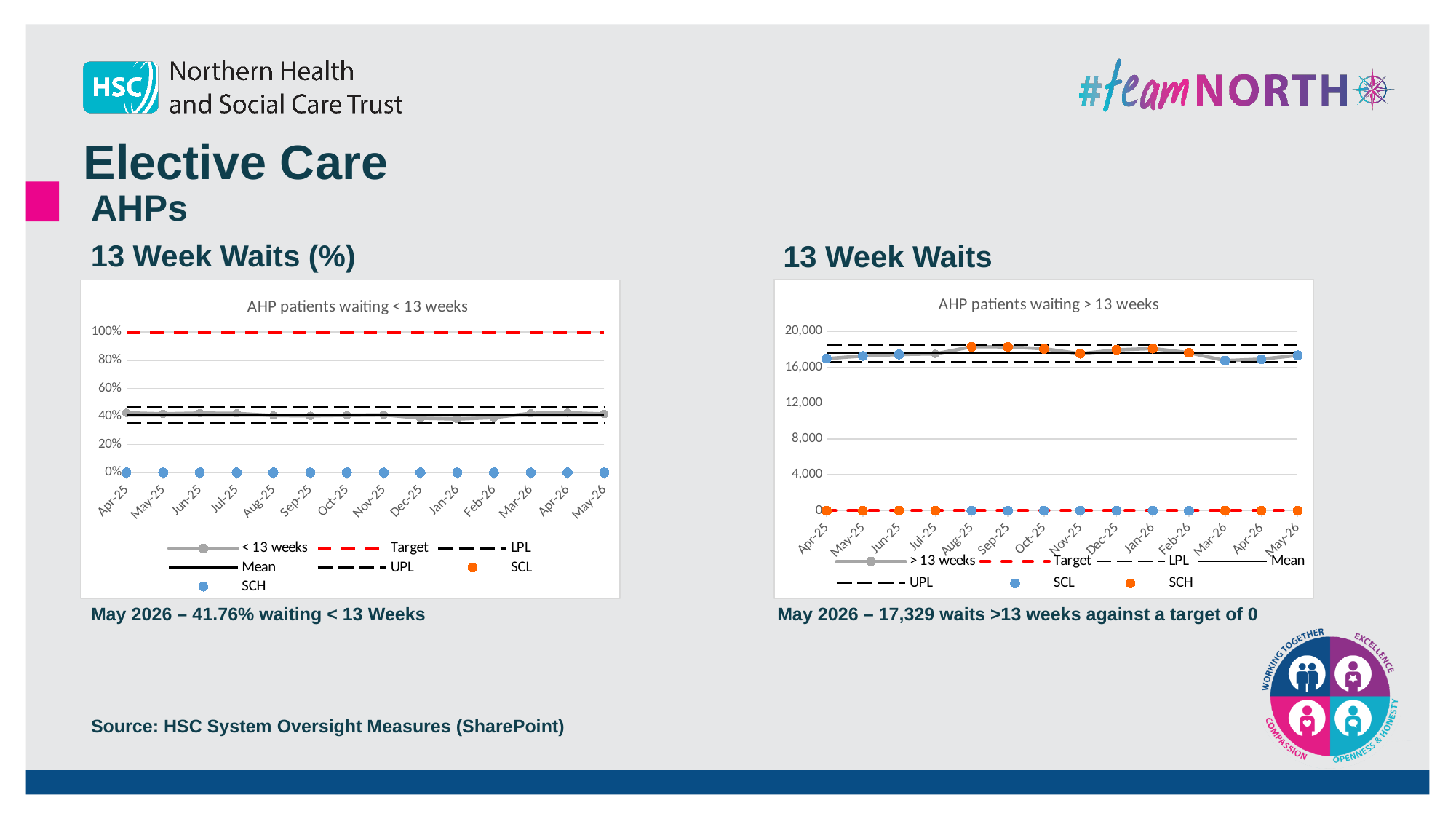
In the 'AHP patients waiting > 13 weeks' chart, is the value for Aug-25 greater or less than 20,000? less According to the caption under the 'AHP patients waiting > 13 weeks' chart, how many waits > 13 weeks were there in May 2026? 17,329 In the 'AHP patients waiting < 13 weeks' chart, at what level is the Target line drawn? 100% How many series does the legend of the 'AHP patients waiting < 13 weeks' chart list? 7 How many months are plotted on the x axis of the 'AHP patients waiting > 13 weeks' chart? 14 In the 'AHP patients waiting < 13 weeks' chart, is the value for Apr-25 greater or less than 60%? less According to the caption under the 'AHP patients waiting < 13 weeks' chart, what percentage were waiting < 13 weeks in May 2026? 41.76% In the 'AHP patients waiting > 13 weeks' chart, is the value for Sep-25 greater or less than 16,000? greater In the 'AHP patients waiting > 13 weeks' chart, what colour is the Target line? red What is the first month shown on the x axis of the 'AHP patients waiting < 13 weeks' chart? Apr-25 What kind of chart is the 'AHP patients waiting < 13 weeks' chart? line chart In the 'AHP patients waiting > 13 weeks' chart, what is the target value? 0